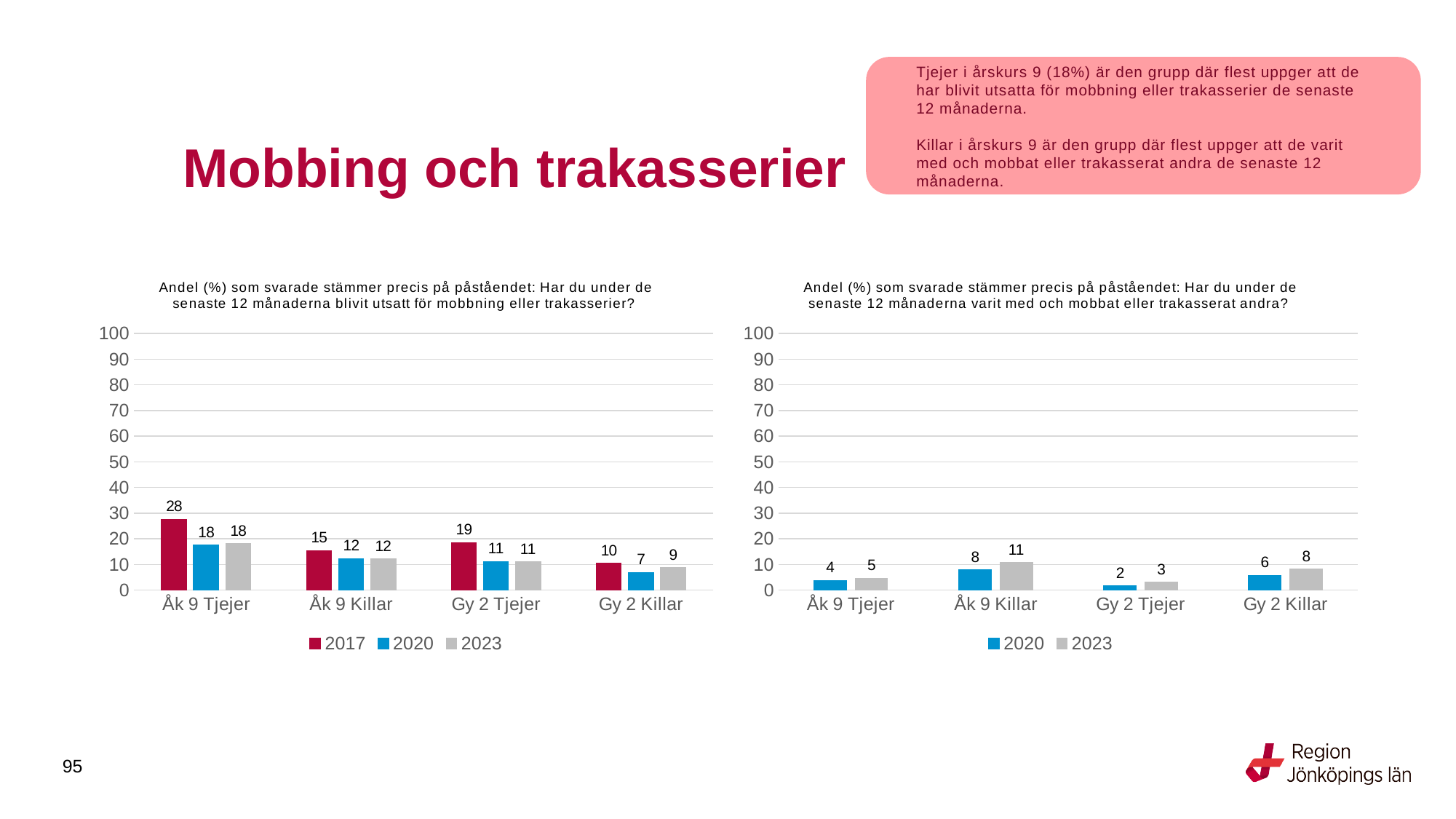
In the left chart, is the 2017 value for Gy 2 Tjejer greater or less than 10? greater Which years are listed in the legend of the right chart? 2020 and 2023 How many series does the legend of the left chart list? 3 In the left chart (blivit utsatt för mobbning eller trakasserier), what is the value for Åk 9 Tjejer in 2017? 28 In the right chart (varit med och mobbat eller trakasserat andra), what is the value for Åk 9 Killar in 2023? 11 In the left chart, which category has the highest value for 2023? Åk 9 Tjejer How many categories are shown on the x axis of the right chart? 4 In the left chart, what is the value for Gy 2 Killar in 2020? 7 In the left chart, what is the difference between the 2017 and 2023 values for Åk 9 Tjejer? 10 What kind of chart is the right chart? Bar chart In the right chart, which category has the lowest value for 2020? Gy 2 Tjejer In the right chart, which is larger for Gy 2 Killar: the 2020 value or the 2023 value? 2023